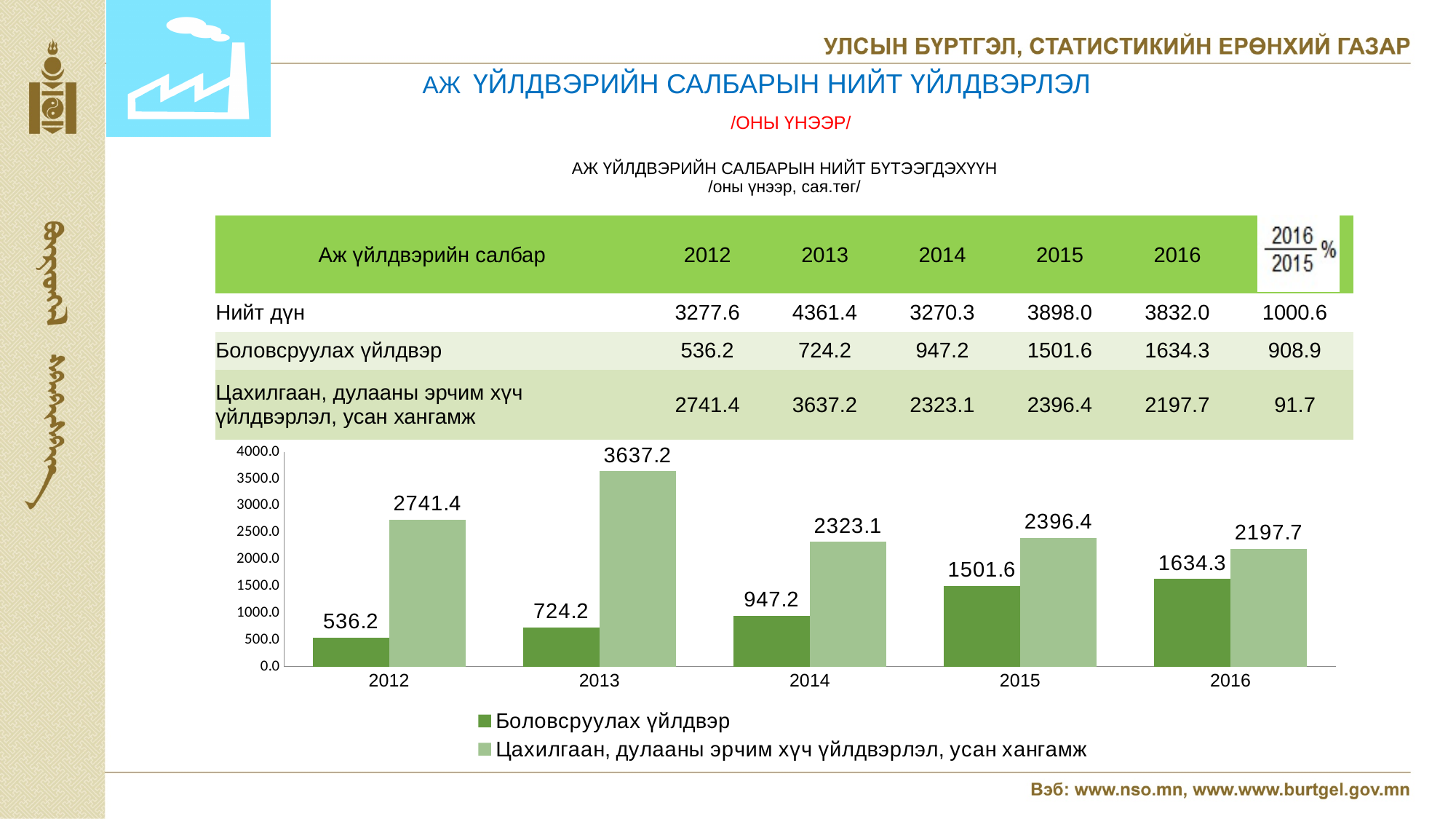
Which series has the larger value in 2015? Цахилгаан, дулааны эрчим хүч үйлдвэрлэл, усан хангамж In which year is the value for Боловсруулах үйлдвэр lowest? 2012 How many years are shown on the x axis of the chart? 5 In which year is the value for Цахилгаан, дулааны эрчим хүч үйлдвэрлэл, усан хангамж highest? 2013 What type of chart is shown on the slide? bar chart How many series does the chart legend list? 2 What is the difference between the two series' values in 2016? 563.4 Does the value for Боловсруулах үйлдвэр rise or fall from 2012 to 2016? rise What is the value for Боловсруулах үйлдвэр in 2014? 947.2 What is the value for Боловсруулах үйлдвэр in 2016? 1634.3 Which series is drawn in the darker green colour? Боловсруулах үйлдвэр What is the value for Цахилгаан, дулааны эрчим хүч үйлдвэрлэл, усан хангамж in 2013? 3637.2